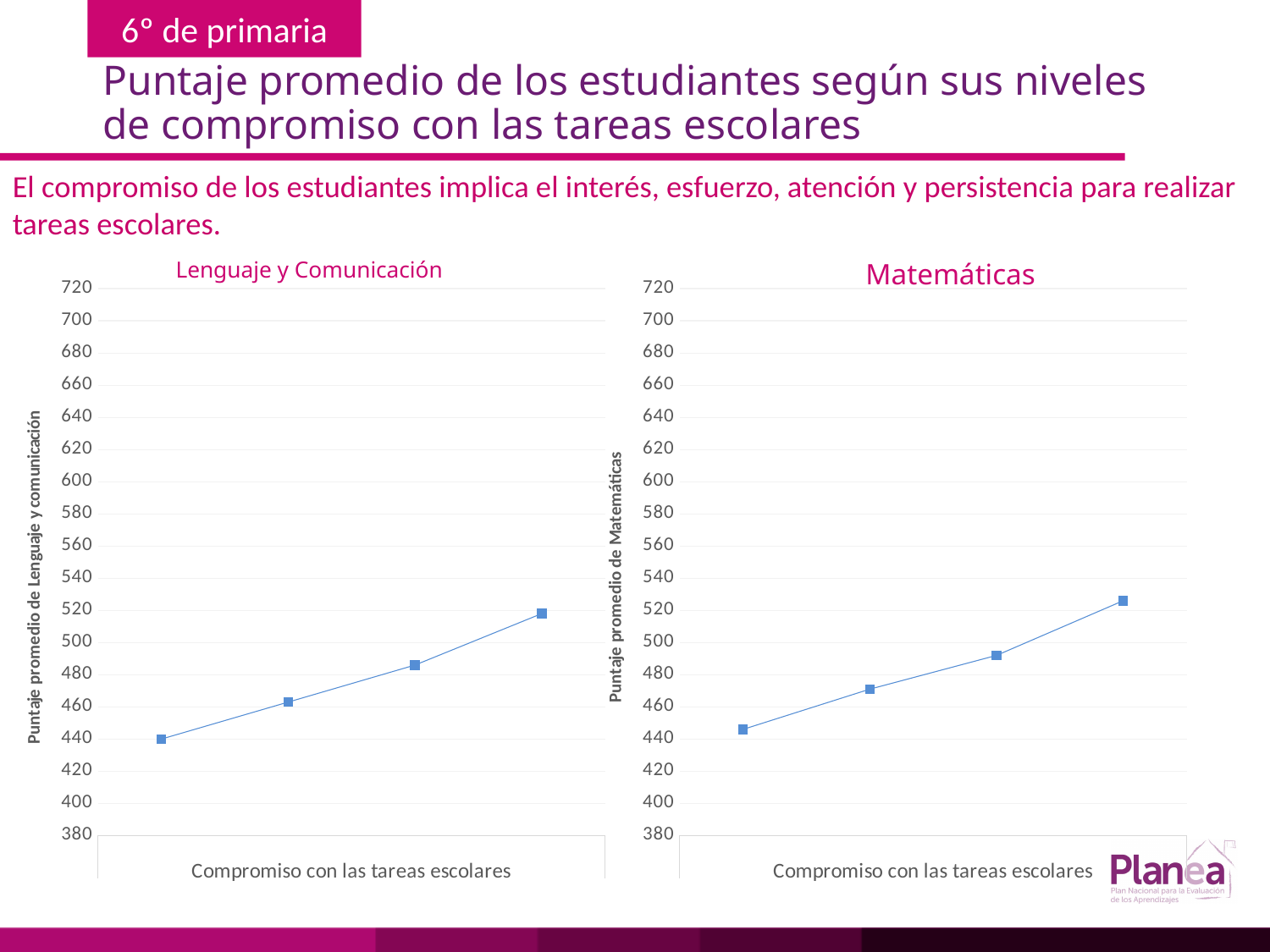
On the 'Lenguaje y Comunicación' chart, is the value of the leftmost point greater or less than 460? less On the 'Matemáticas' chart, is the value of the leftmost point greater or less than 460? less On the 'Matemáticas' chart, is the value of the rightmost point greater or less than 520? greater On the 'Matemáticas' chart, do the values rise or fall from left to right along the x axis? rise What is the x-axis label on the 'Lenguaje y Comunicación' chart? Compromiso con las tareas escolares What kind of chart is the 'Matemáticas' chart? line chart What kind of chart is the 'Lenguaje y Comunicación' chart? line chart On the 'Matemáticas' chart, which point is higher, the leftmost or the rightmost? the rightmost How many data points are plotted on the 'Matemáticas' chart? 4 How many data points are plotted on the 'Lenguaje y Comunicación' chart? 4 On the 'Lenguaje y Comunicación' chart, do the values rise or fall from left to right along the x axis? rise